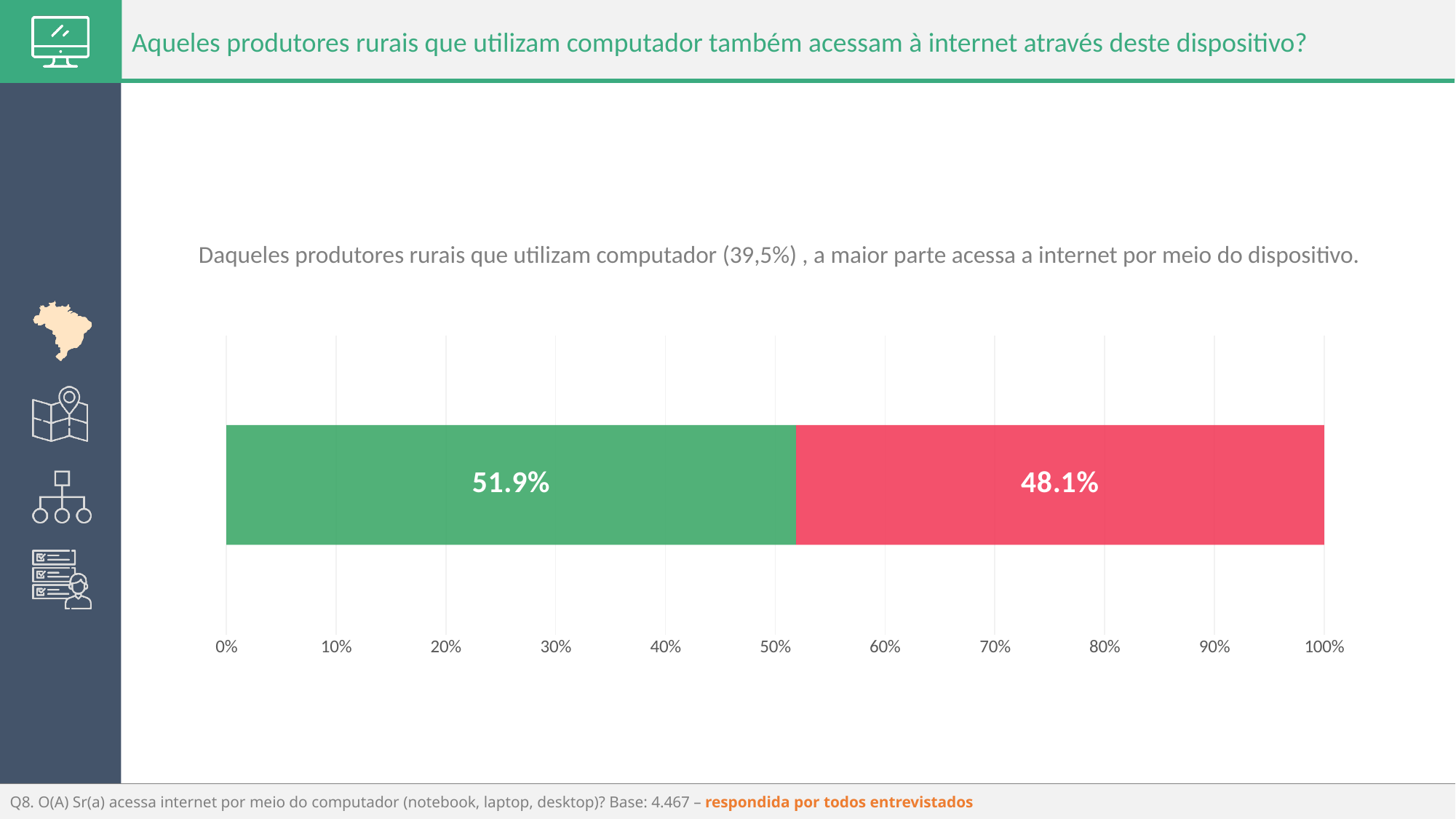
What is the difference between the green segment value and the red segment value? 3.8% What colour is the segment with the value 48.1%? red What value is shown on the green segment of the bar? 51.9% Is the value of the red segment greater or less than 50%? less What is the highest value shown on the x axis? 100% Which segment of the bar is larger, the green one or the red one? the green one Is the value of the green segment greater or less than 50%? greater What is the total of the two segments in the stacked bar? 100% What value is shown on the red segment of the bar? 48.1% What kind of chart is shown on the slide? bar chart How many segments make up the stacked bar? 2